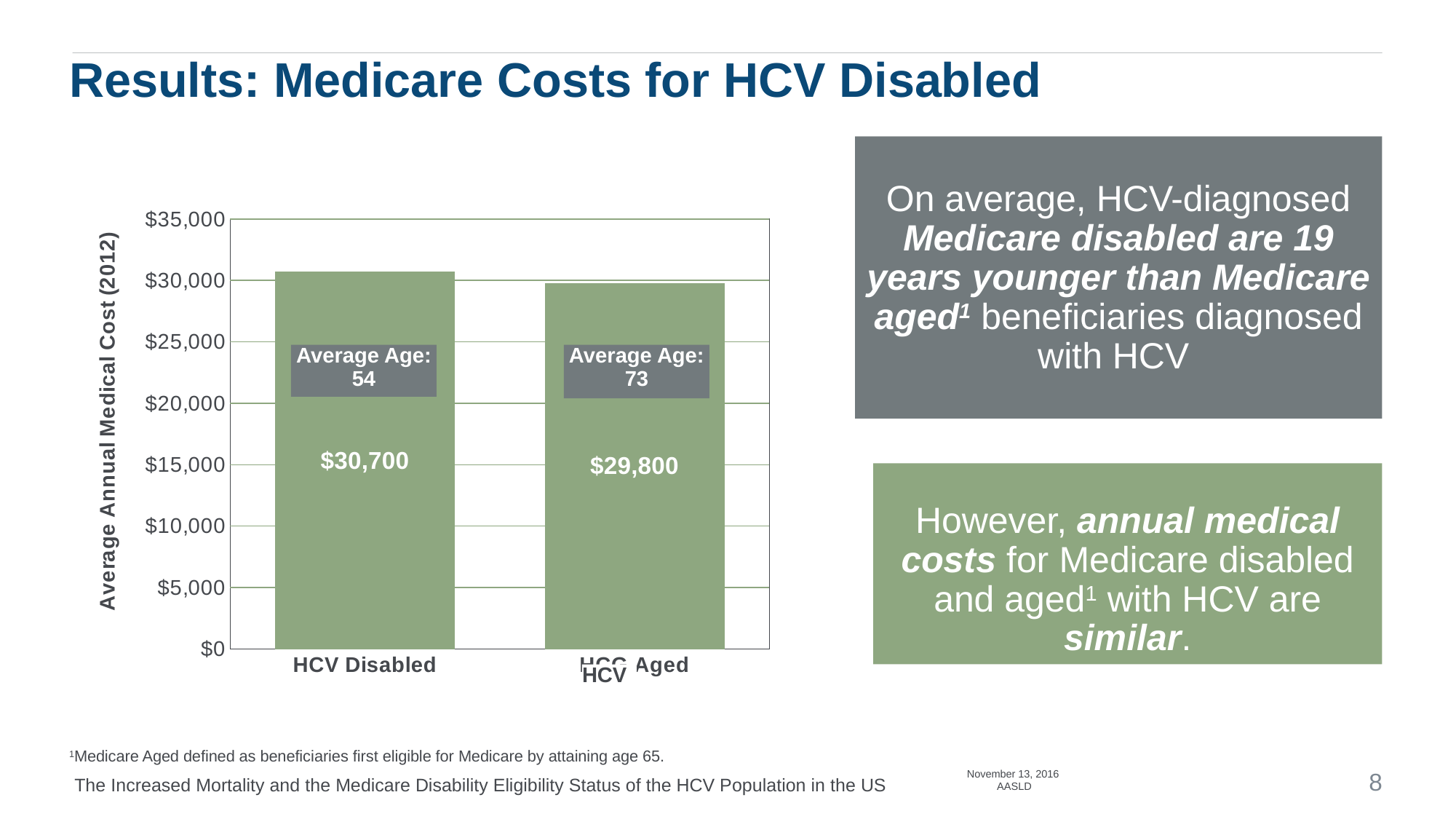
What kind of chart is shown on the slide? bar chart What is the average annual medical cost for HCV Disabled? $30,700 What is the average age shown for the HCV Disabled group? 54 How many categories are shown on the chart? 2 Which category has the lower average annual medical cost? HCV Aged What is the average annual medical cost for HCV Aged? $29,800 What is the label of the vertical axis of the chart? Average Annual Medical Cost (2012) Is the average annual medical cost for HCV Aged greater or less than $30,000? less Is the average annual medical cost for HCV Disabled greater or less than $30,000? greater What is the difference in average annual medical cost between HCV Disabled and HCV Aged? $900 Which category has the higher average annual medical cost? HCV Disabled What is the average age shown for the HCV Aged group? 73